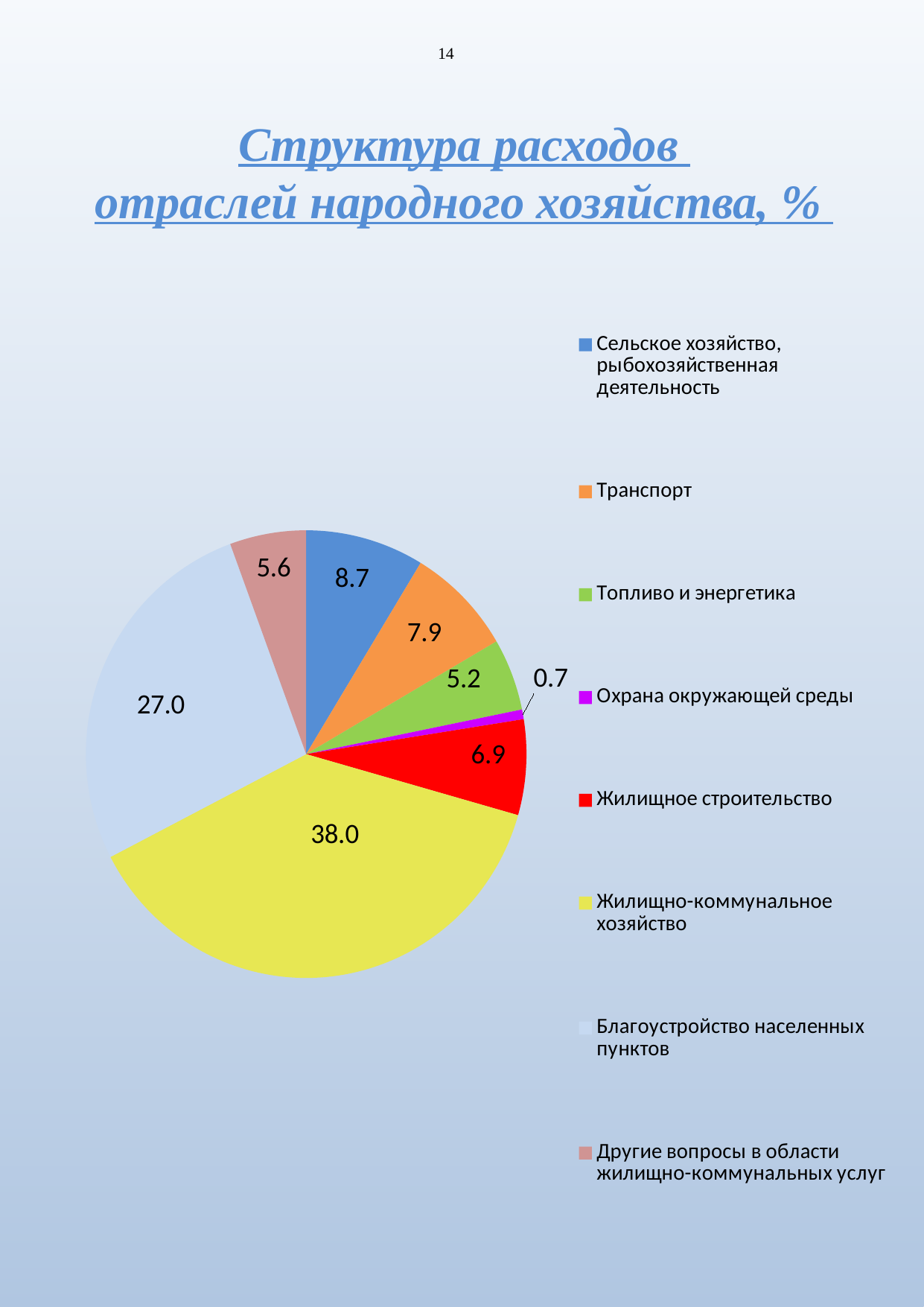
What type of chart is shown on the slide? pie chart What colour is the slice for "Жилищное строительство"? red What is the title of the chart? Структура расходов отраслей народного хозяйства, % What is the value for "Жилищно-коммунальное хозяйство"? 38.0 What is the difference between the values for "Жилищно-коммунальное хозяйство" and "Благоустройство населенных пунктов"? 11.0 Which category has the smallest slice? Охрана окружающей среды Which category has the largest slice? Жилищно-коммунальное хозяйство What is the value for "Транспорт"? 7.9 What is the value for "Благоустройство населенных пунктов"? 27.0 Which is larger, "Сельское хозяйство, рыбохозяйственная деятельность" or "Жилищное строительство"? Сельское хозяйство, рыбохозяйственная деятельность What is the value for "Охрана окружающей среды"? 0.7 How many slices does the pie chart have? 8